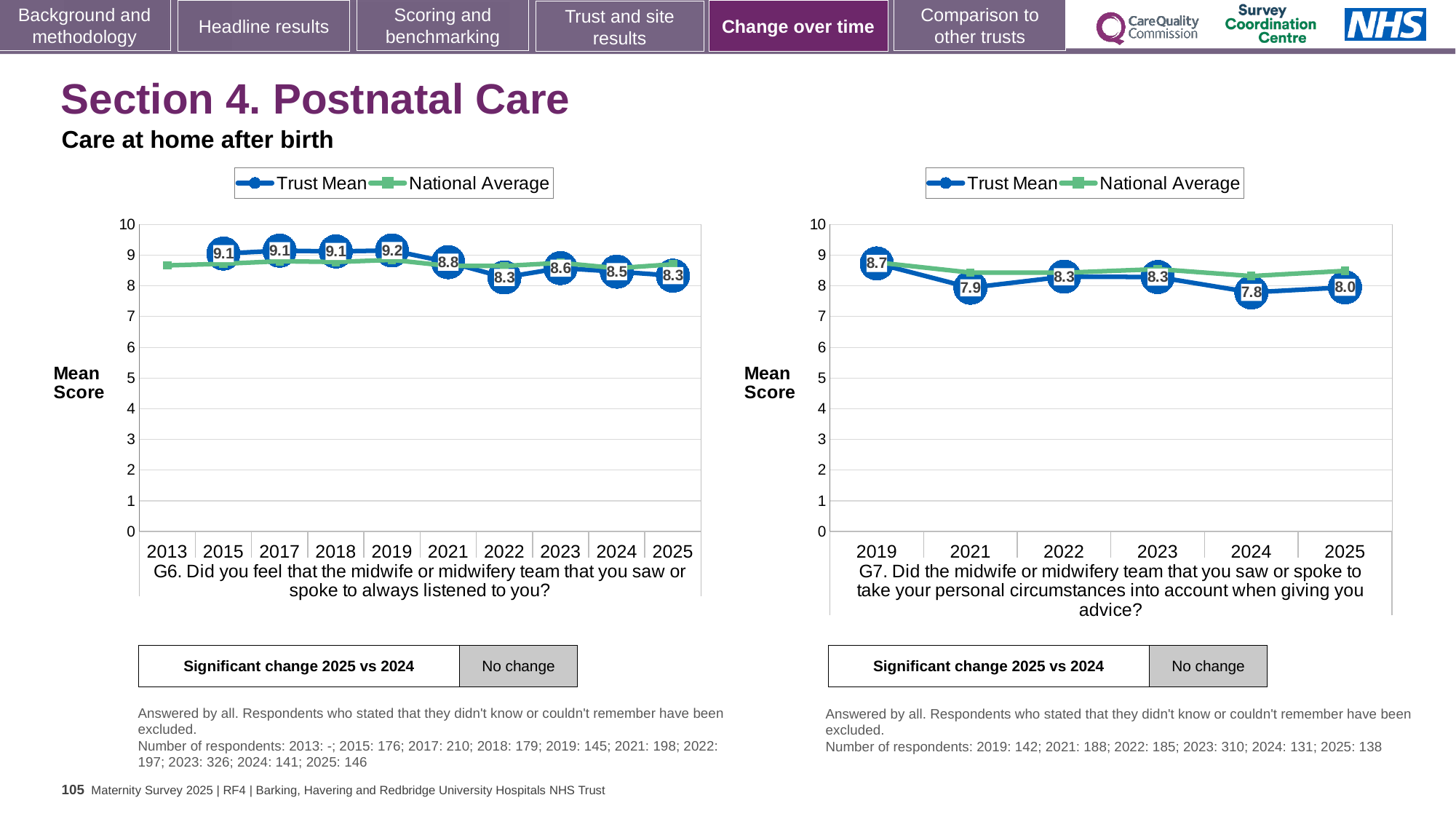
In the G7 chart on the right, what is the difference between the Trust Mean scores for 2019 and 2024? 0.9 In the G7 chart on the right, what is the Trust Mean score for 2021? 7.9 How many years are shown on the x axis of the G7 chart on the right? 6 In the G6 chart on the left, is the National Average value for 2013 greater or less than 9? less In the G6 chart on the left, which year has the highest Trust Mean score? 2019 In the G6 chart on the left, what is the difference between the Trust Mean scores for 2019 and 2025? 0.9 In the G7 chart on the right, which year has the lowest Trust Mean score? 2024 In the G6 chart on the left, what is the Trust Mean score for 2025? 8.3 In the G7 chart on the right, which year has the highest Trust Mean score? 2019 How many series does the legend of the G6 chart on the left list? 2 In the G6 chart on the left, what is the Trust Mean score for 2019? 9.2 In the G7 chart on the right, is the Trust Mean score for 2022 larger or smaller than the score for 2025? larger